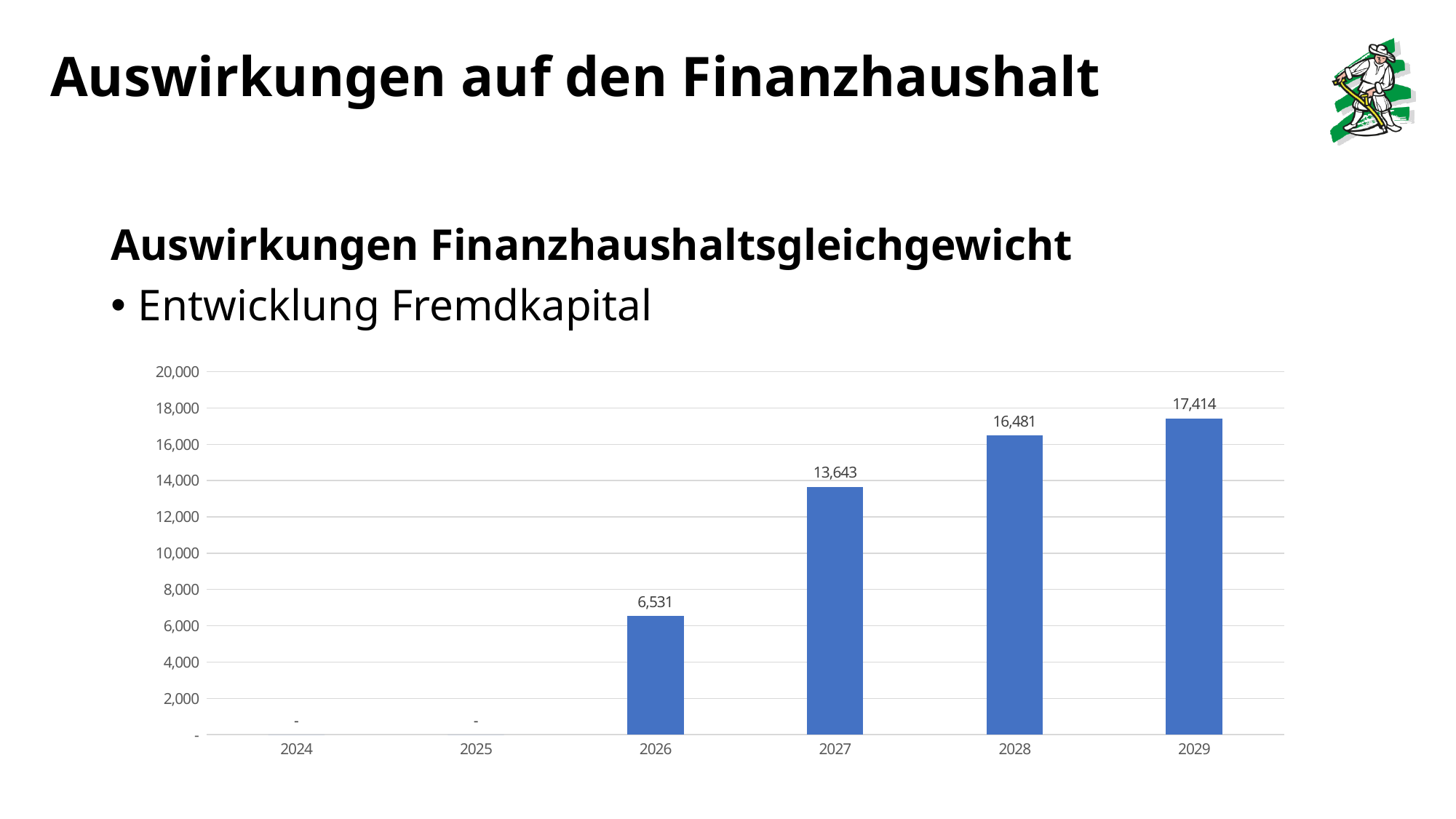
What kind of chart is shown? bar chart What is the difference between the values for 2029 and 2028? 933 What is the value for 2029? 17,414 Which is larger, the value for 2027 or the value for 2028? 2028 Is the value for 2027 greater or less than 12,000? greater What is the value for 2028? 16,481 What is the value for 2027? 13,643 Do the values rise or fall from 2026 to 2029? rise How many years are shown on the x axis? 6 Which year has the highest value? 2029 What is the difference between the values for 2027 and 2026? 7,112 What is the value for 2026? 6,531